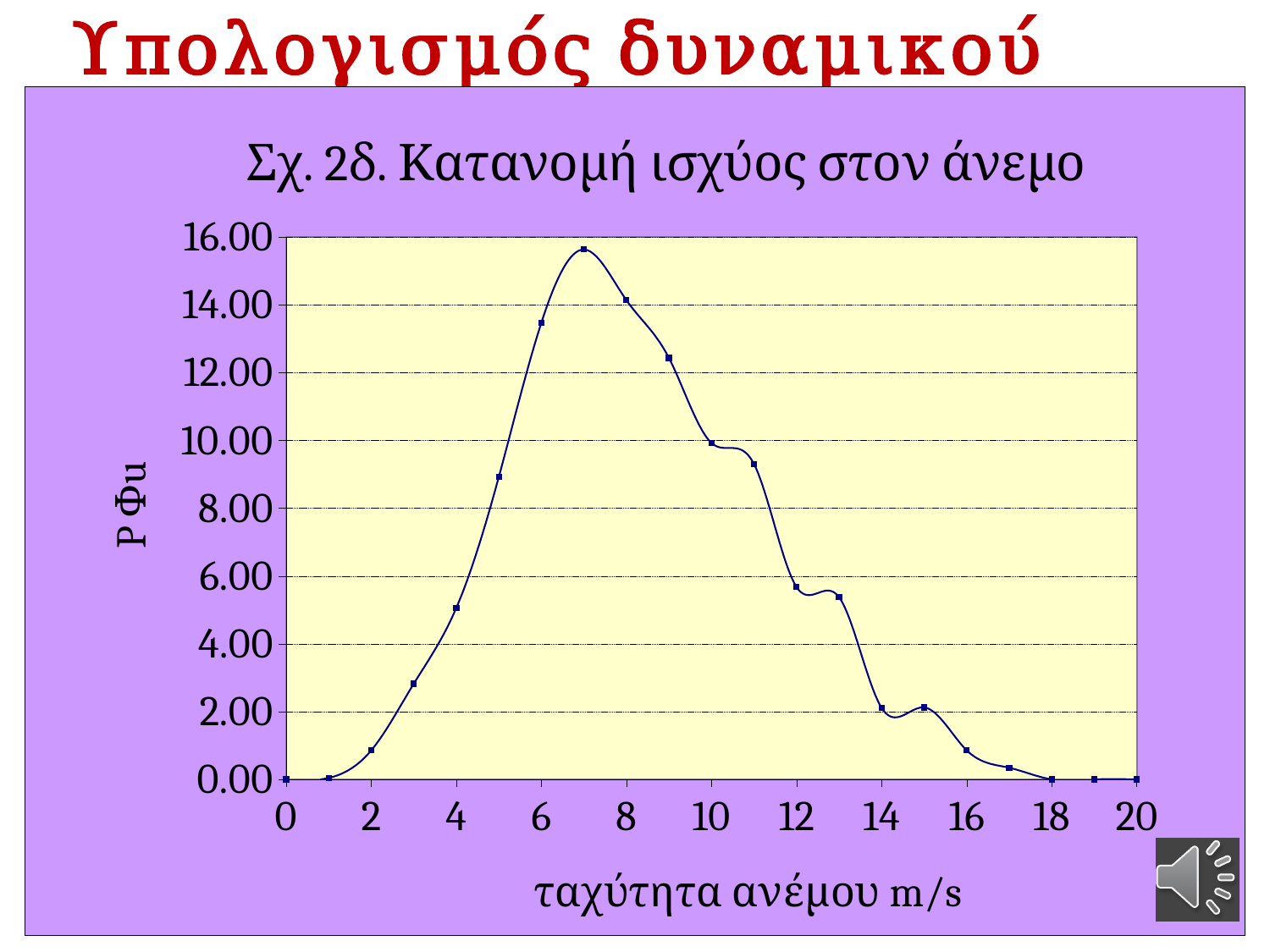
What kind of chart is shown on the slide? line chart Is the value at wind speed 6 m/s greater or less than 12.00? greater What is the title of the chart? Σχ. 2δ. Κατανομή ισχύος στον άνεμο Which has the larger value: wind speed 3 m/s or wind speed 14 m/s? 3 m/s How many data points are plotted on the curve? 21 Between wind speeds 7 m/s and 18 m/s, does the curve rise or fall? fall Which has the larger value: wind speed 6 m/s or wind speed 10 m/s? 6 m/s At which wind speed (m/s) does the curve reach its highest value? 7 Is the value at wind speed 12 m/s greater or less than 8.00? less Is the value at wind speed 7 m/s greater or less than 14.00? greater What is the label of the x axis? ταχύτητα ανέμου m/s